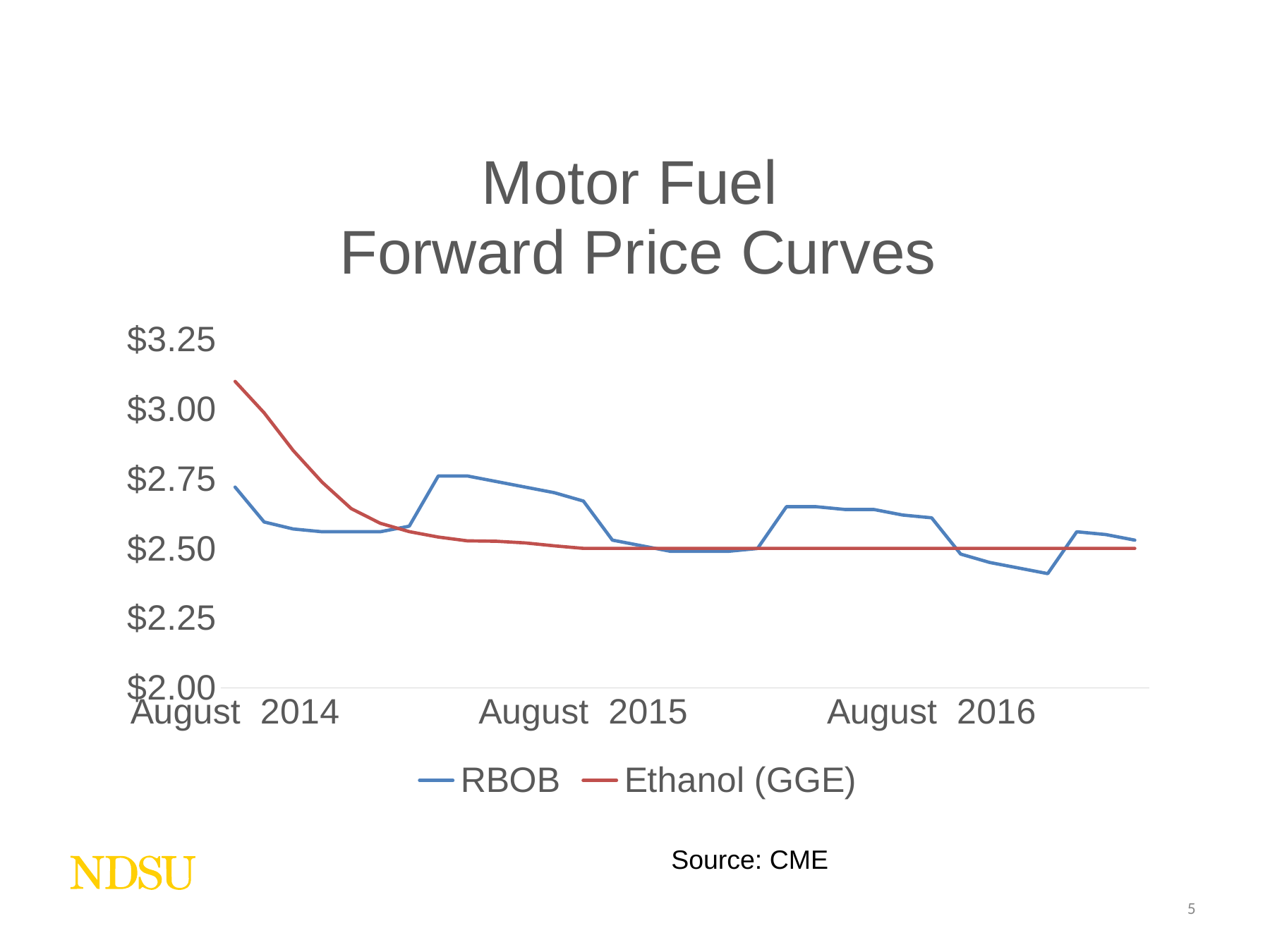
At August 2014, which series has the higher value, RBOB or Ethanol (GGE)? Ethanol (GGE) Which series is drawn in red? Ethanol (GGE) How many labelled points are shown on the x axis? 3 Is the Ethanol (GGE) value at August 2016 greater or less than $2.75? less Is the Ethanol (GGE) value at August 2014 greater or less than $3.00? greater How many series does the legend list? 2 What kind of chart is shown on the slide? line chart Which series has the highest value anywhere on the chart? Ethanol (GGE) Does the Ethanol (GGE) line generally rise or fall from August 2014 to August 2016? fall What is the title of the chart? Motor Fuel Forward Price Curves Is the lowest point of the RBOB line greater or less than $2.50? less